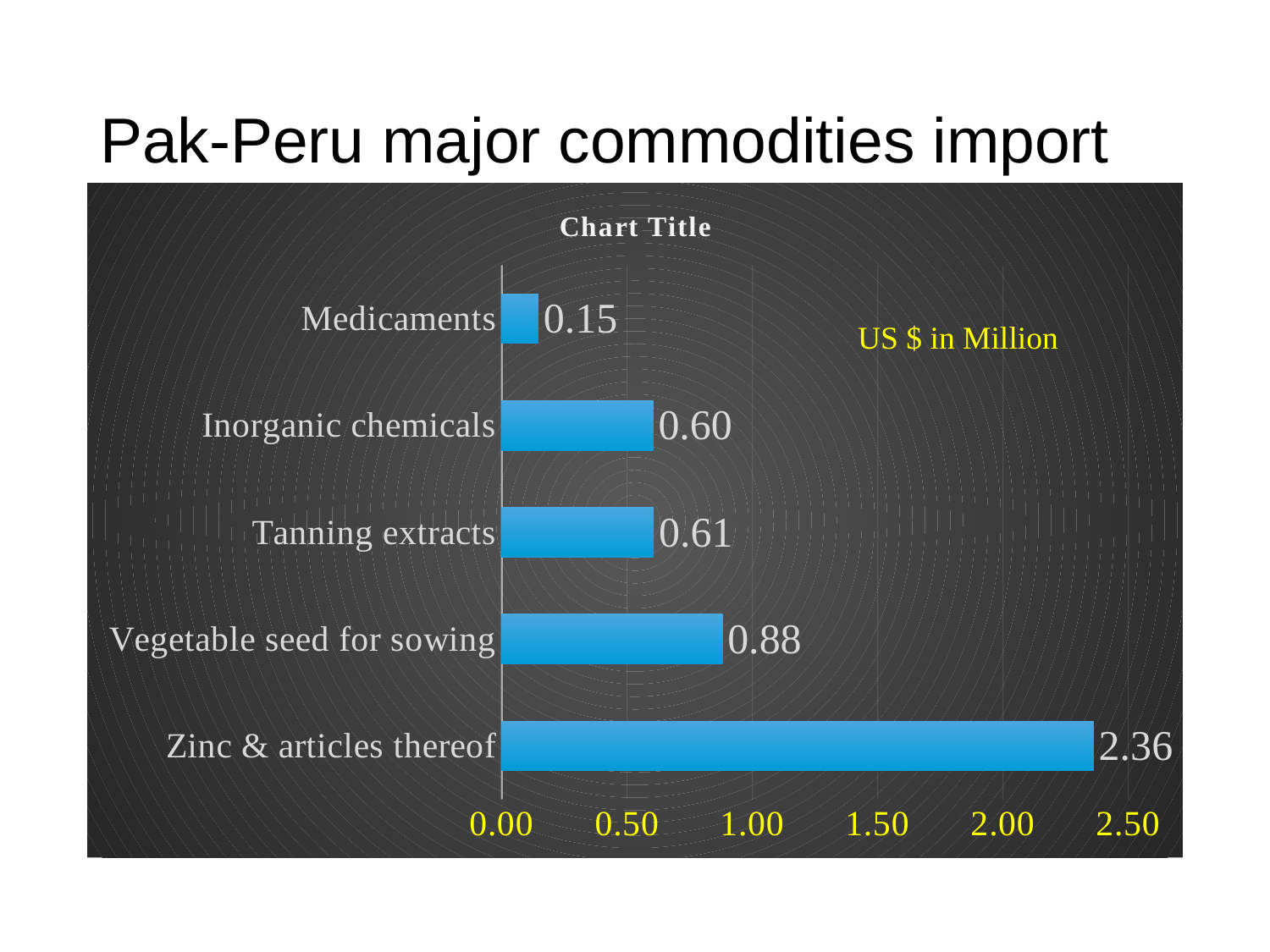
What is the import value for Zinc & articles thereof? 2.36 Which commodity has the lowest import value? Medicaments Which commodity has the highest import value? Zinc & articles thereof Which has a larger import value, Vegetable seed for sowing or Tanning extracts? Vegetable seed for sowing What is the import value for Medicaments? 0.15 What is the difference between the import values of Zinc & articles thereof and Vegetable seed for sowing? 1.48 What unit is stated for the values in the chart? US $ in Million Is the value for Zinc & articles thereof greater or less than 2.00? greater What kind of chart is shown on the slide? bar chart How many commodities are shown in the chart? 5 What is the import value for Vegetable seed for sowing? 0.88 What is the import value for Inorganic chemicals? 0.60